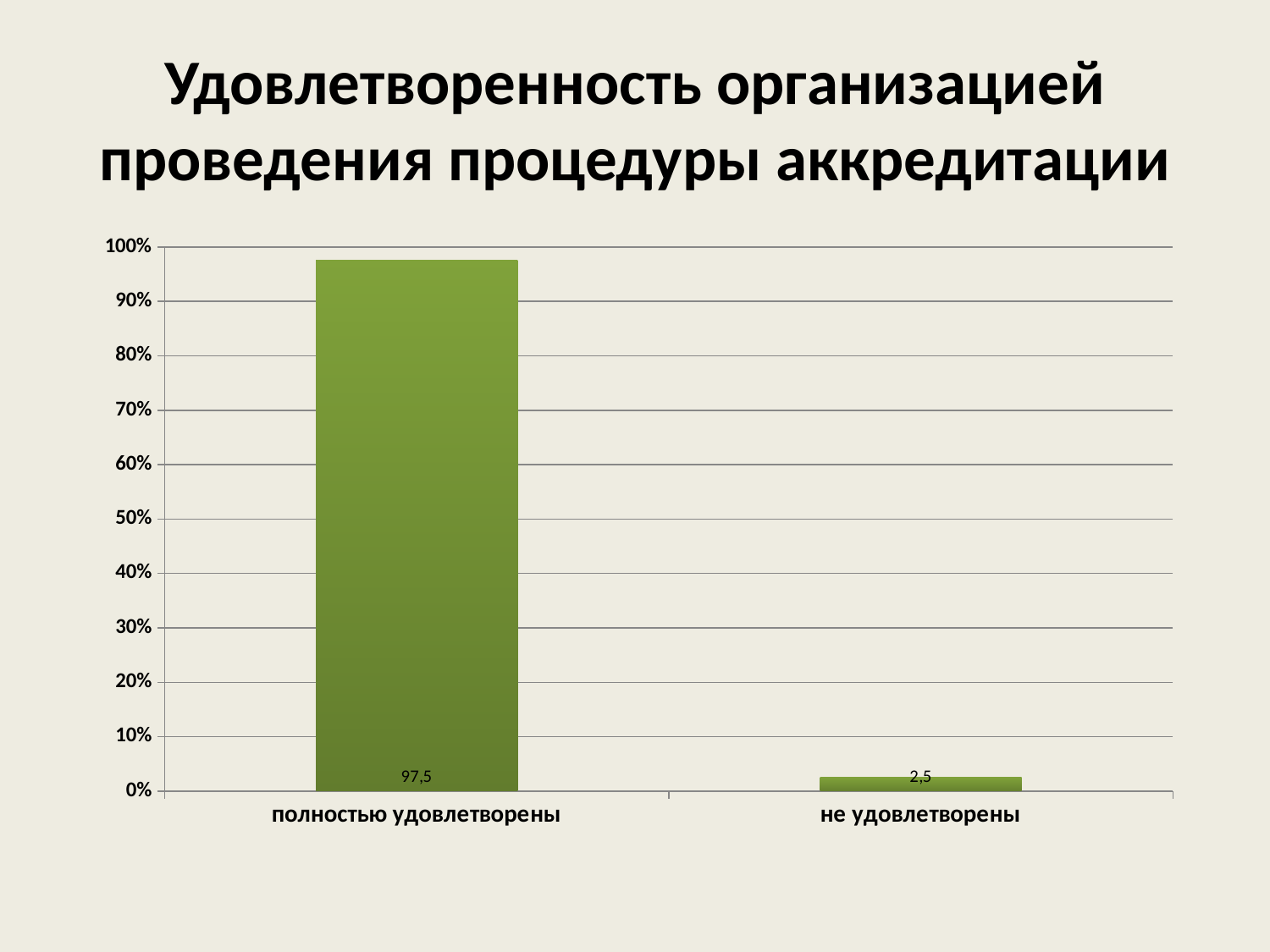
What is the title of the slide? Удовлетворенность организацией проведения процедуры аккредитации Is the value for "не удовлетворены" greater or less than 10%? less Which is larger: the value for "полностью удовлетворены" or for "не удовлетворены"? полностью удовлетворены What is the value for "полностью удовлетворены"? 97,5 Is the value for "полностью удовлетворены" greater or less than 90%? greater How many categories are shown on the x axis? 2 What is the difference between the values for "полностью удовлетворены" and "не удовлетворены"? 95 What is the total of the two plotted values? 100 What is the value for "не удовлетворены"? 2,5 Which category has the lowest value? не удовлетворены Which category has the highest value? полностью удовлетворены What kind of chart is shown on the slide? bar chart